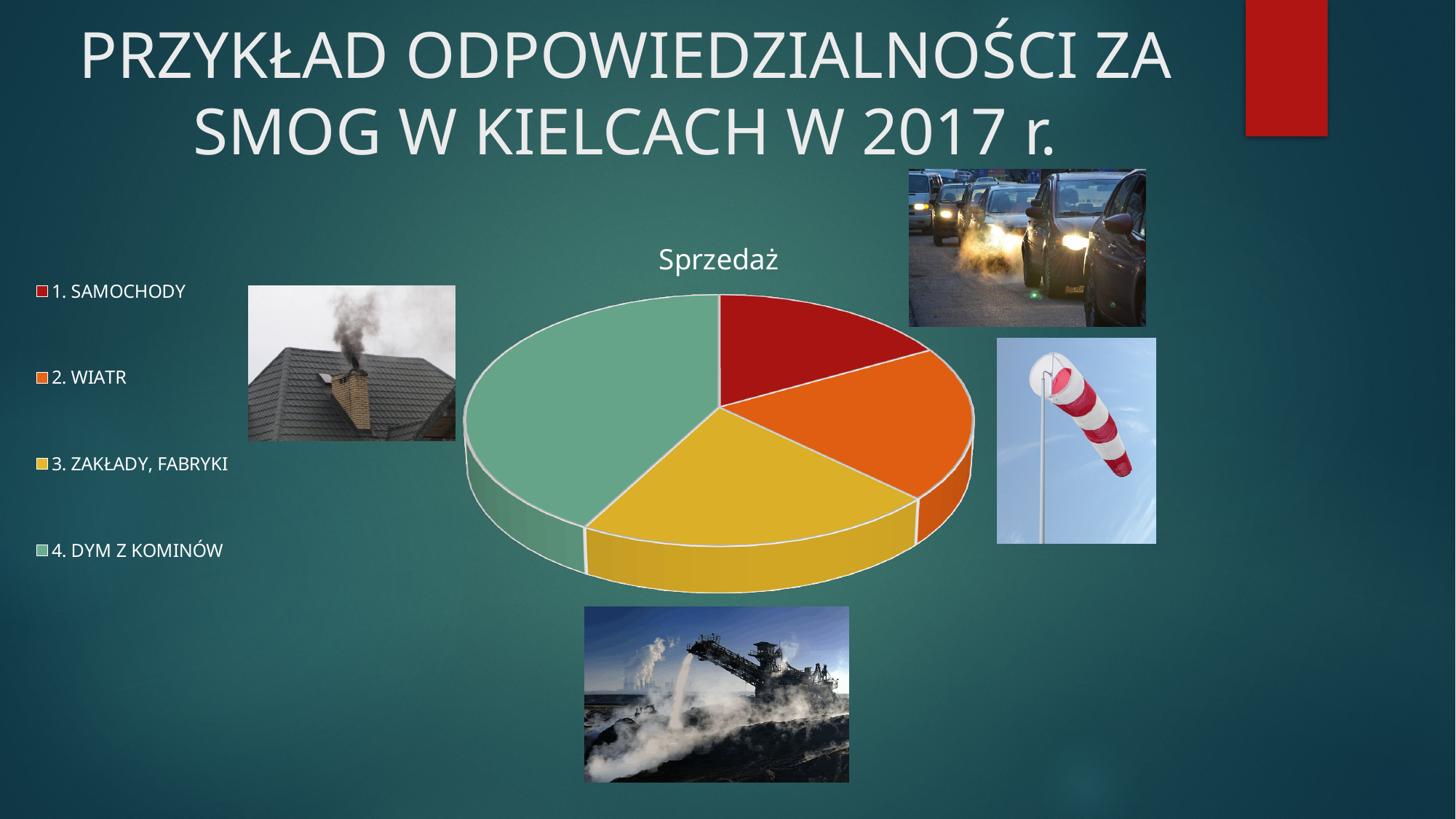
Which category is shown in red on the pie chart? 1. SAMOCHODY Which slice is larger: 4. DYM Z KOMINÓW or 3. ZAKŁADY, FABRYKI? 4. DYM Z KOMINÓW Which category has the smallest slice of the pie chart? 1. SAMOCHODY Which category has the largest slice of the pie chart? 4. DYM Z KOMINÓW Which slice is larger: 1. SAMOCHODY or 4. DYM Z KOMINÓW? 4. DYM Z KOMINÓW Which slice is larger: 1. SAMOCHODY or 2. WIATR? 2. WIATR What colour is the slice for 3. ZAKŁADY, FABRYKI? yellow What is the title of the pie chart? Sprzedaż How many categories does the pie chart have? 4 What kind of chart is shown on the slide? pie chart